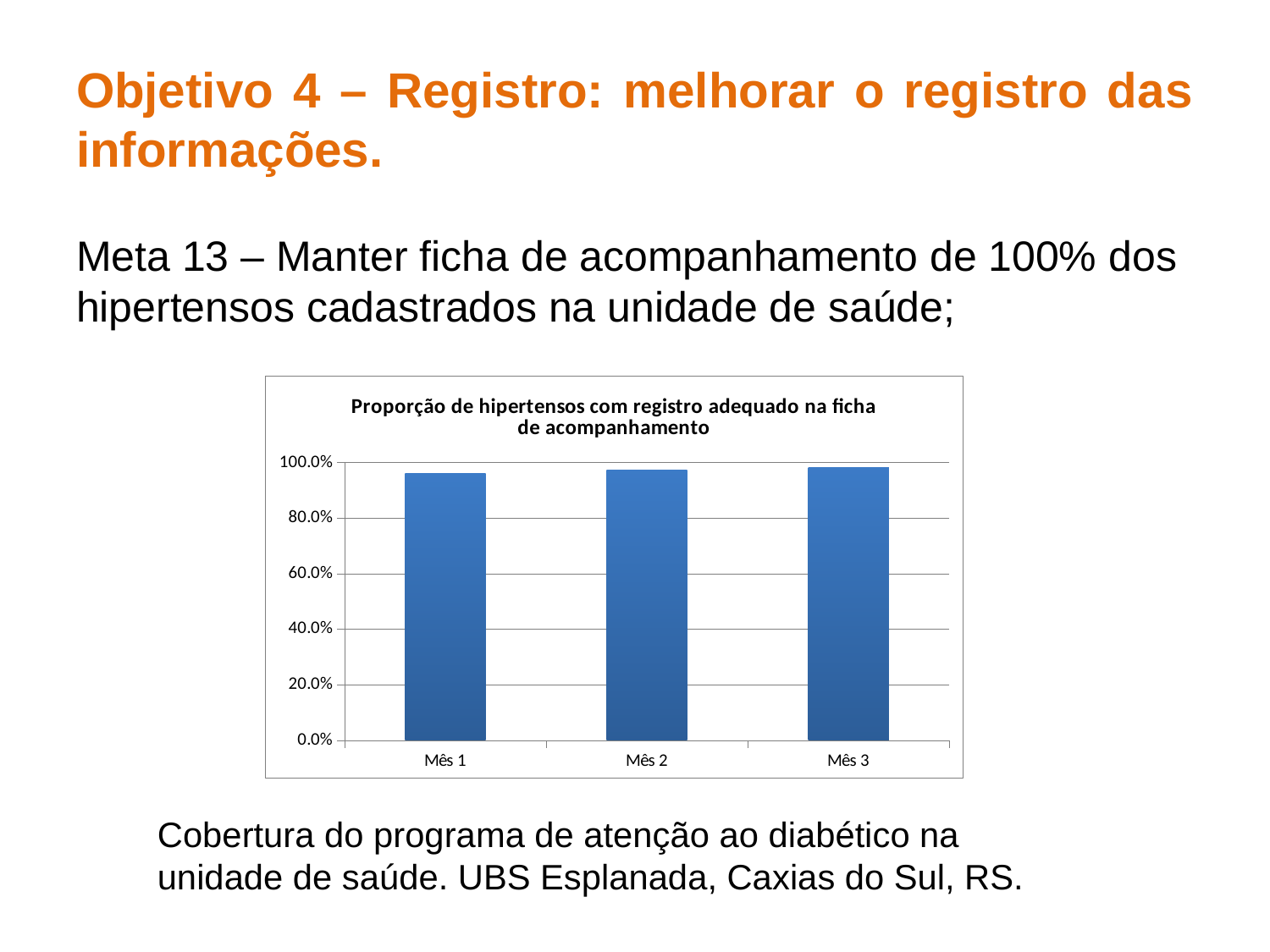
How many categories (months) are plotted on the x axis of the chart? 3 Is the value for Mês 3 greater or less than 100.0%? less Which is larger, the value for Mês 1 or the value for Mês 3? Mês 3 Is the value for Mês 1 greater or less than 80.0%? greater Is the value for Mês 2 greater or less than 60.0%? greater What is the highest tick value shown on the y axis? 100.0% What is the label of the first category on the x axis? Mês 1 Do the values rise or fall from Mês 1 to Mês 3? rise What kind of chart is shown on the slide? bar chart What is the title of the chart? Proporção de hipertensos com registro adequado na ficha de acompanhamento